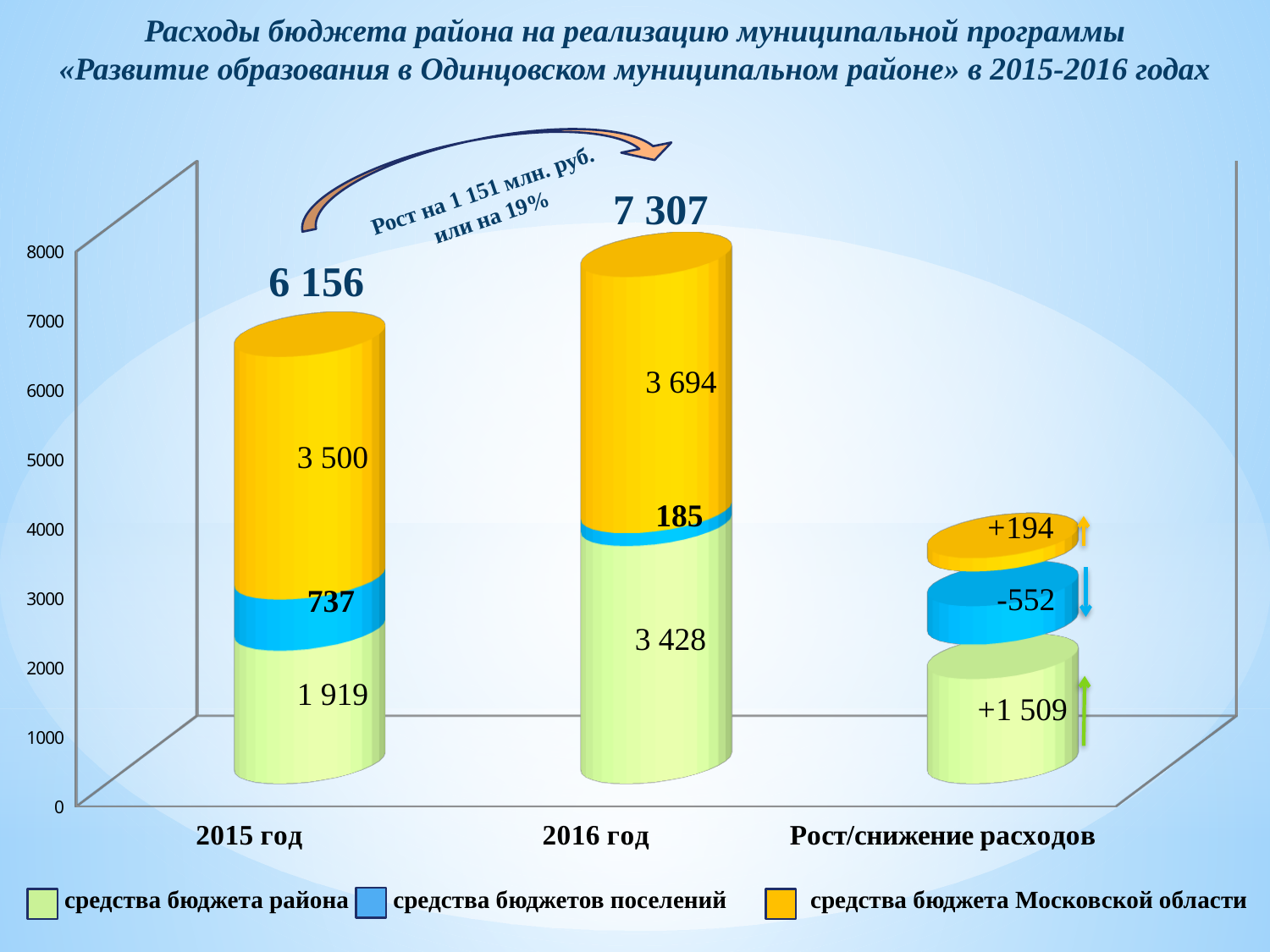
What is the value for средства бюджетов поселений in 2016 год? 185 What is the value shown for средства бюджетов поселений in the Рост/снижение расходов category? -552 Which series has the highest value in 2015 год? средства бюджета Московской области What is the total of the stacked bar for 2016 год? 7 307 What is the value for средства бюджета района in 2015 год? 1 919 What is the value for средства бюджета Московской области in 2016 год? 3 694 Which series has the lowest value in 2016 год? средства бюджетов поселений How many series does the legend list? 3 Which is larger: средства бюджетов поселений in 2015 год or in 2016 год? 2015 год What kind of chart is shown on the slide? Stacked bar chart What is the difference between the средства бюджета района values for 2016 год and 2015 год? 1 509 What is the total of the stacked bar for 2015 год? 6 156